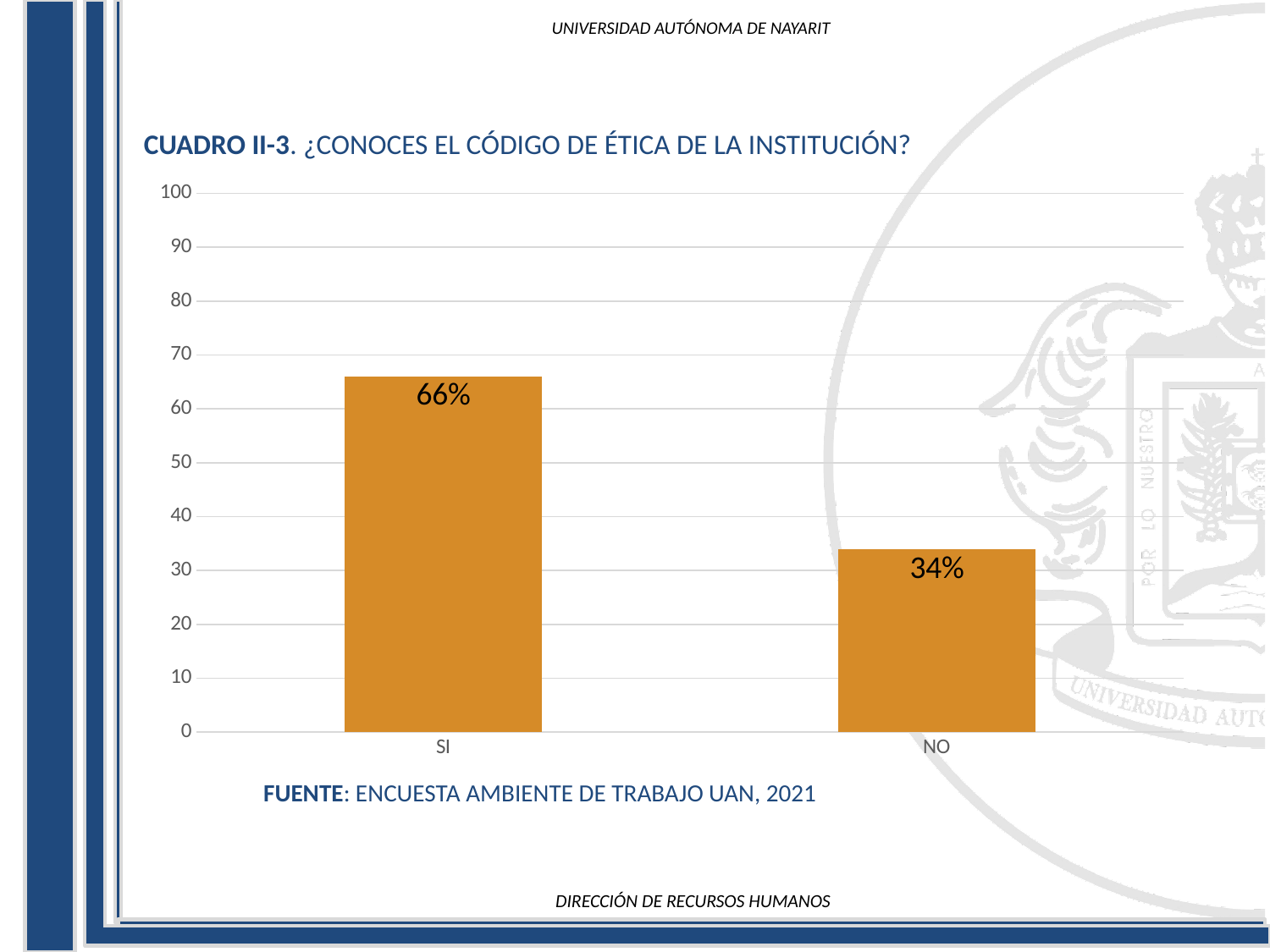
Which category has the lowest value? NO How many categories are shown on the x axis? 2 What is the title of the chart? CUADRO II-3. ¿CONOCES EL CÓDIGO DE ÉTICA DE LA INSTITUCIÓN? What is the difference between the values for SI and NO? 32% Which category has the highest value? SI What source is cited below the chart? ENCUESTA AMBIENTE DE TRABAJO UAN, 2021 What is the value for NO? 34% Is the value for NO greater or less than 40? less What is the value for SI? 66% Which is larger, the value for SI or the value for NO? SI What kind of chart is shown on the slide? bar chart Is the value for SI greater or less than 60? greater